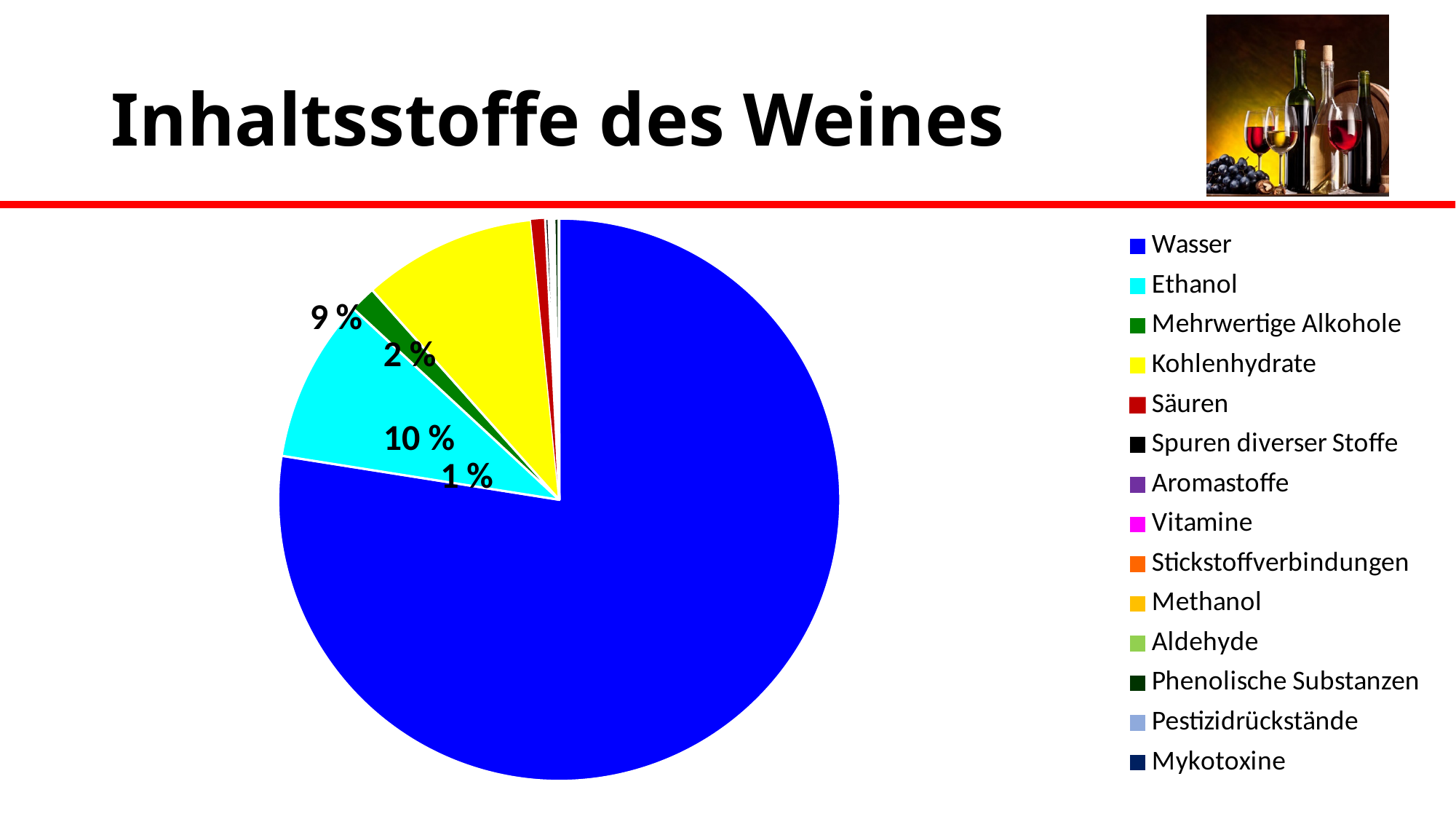
Which category is shown in yellow in the pie chart? Kohlenhydrate What is the title of the slide containing the pie chart? Inhaltsstoffe des Weines Which category has the largest slice in the pie chart? Wasser What kind of chart is shown on the slide? pie chart Which slice is larger, Wasser or Ethanol? Wasser Which slice is larger, Kohlenhydrate or Säuren? Kohlenhydrate Which slice is larger, Ethanol or Mehrwertige Alkohole? Ethanol How many categories does the legend of the pie chart list? 14 What colour is the Wasser slice in the pie chart? blue